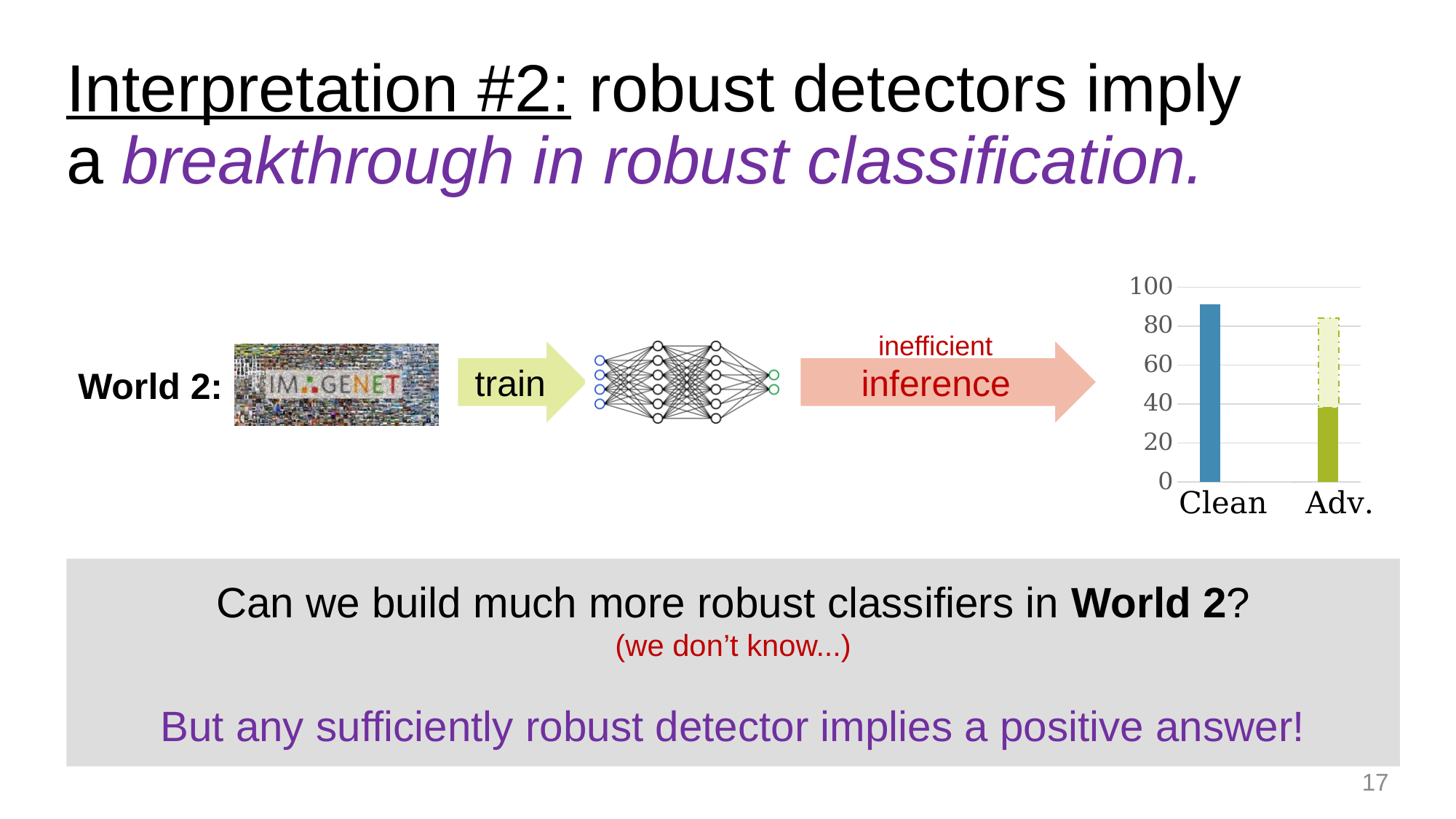
What is the highest tick value shown on the y axis of the chart? 100 Is the value of the Clean bar greater or less than 100? less Is the value of the solid Adv. bar greater or less than 20? greater Is the value of the Clean bar greater or less than 80? greater What kind of chart is shown on the right of the slide? bar chart Which category has the lowest solid bar in the chart? Adv. Which category has the highest solid bar in the chart? Clean How many categories are shown on the x axis of the bar chart? 2 What colour is the Clean bar in the chart? blue Which category has the taller solid bar in the chart, Clean or Adv.? Clean